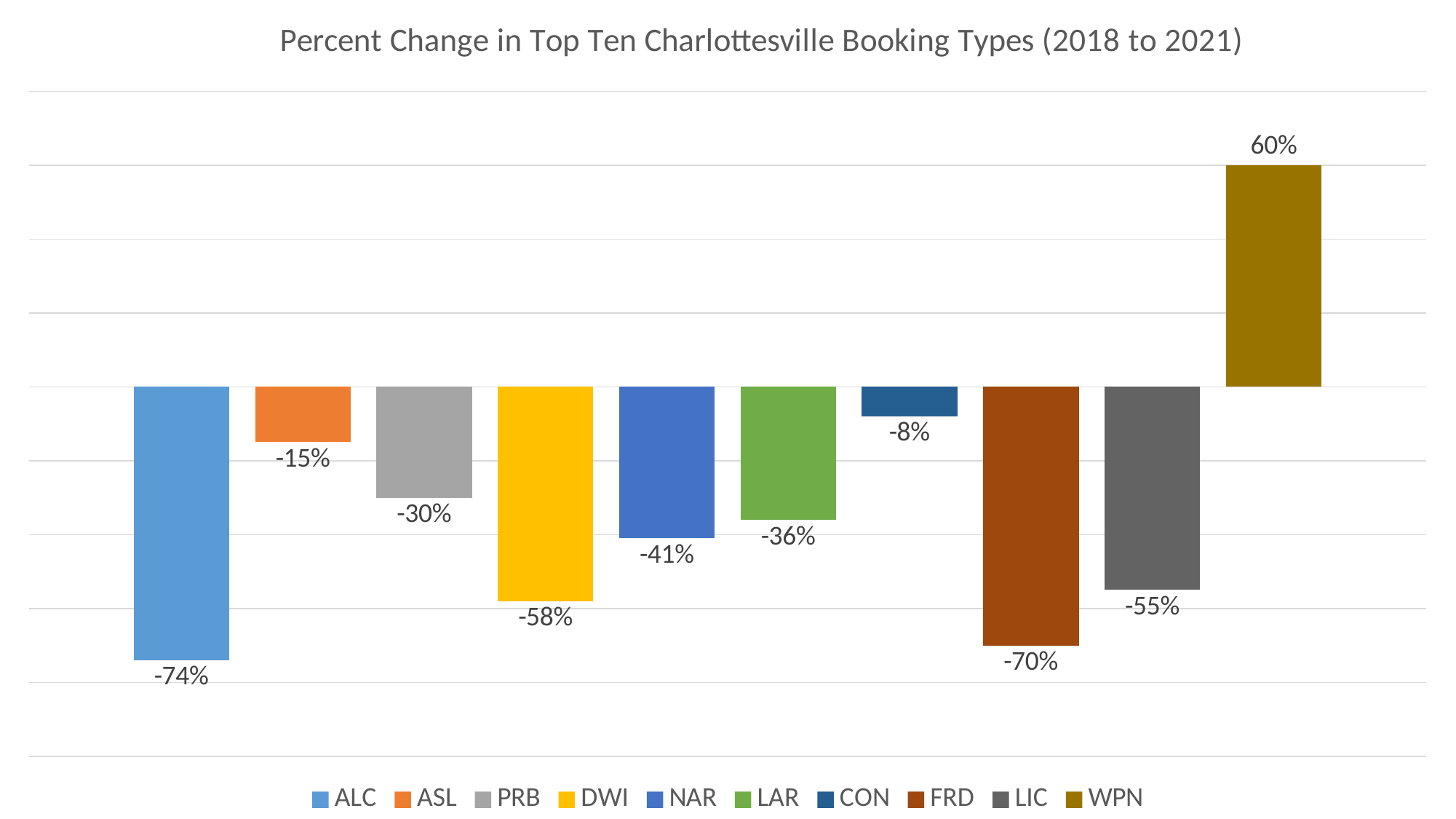
What is the percent change for DWI? -58% How many booking types are shown in the chart? 10 What is the percent change for CON? -8% What is the percent change for WPN? 60% Which booking type has the lowest percent change? ALC How many entries does the legend list? 10 What is the difference between the percent change for ALC and the percent change for FRD? 4 percentage points What is the percent change for LIC? -55% What kind of chart is shown on the slide? Bar chart Which booking type has the highest percent change? WPN What is the title of the chart? Percent Change in Top Ten Charlottesville Booking Types (2018 to 2021)